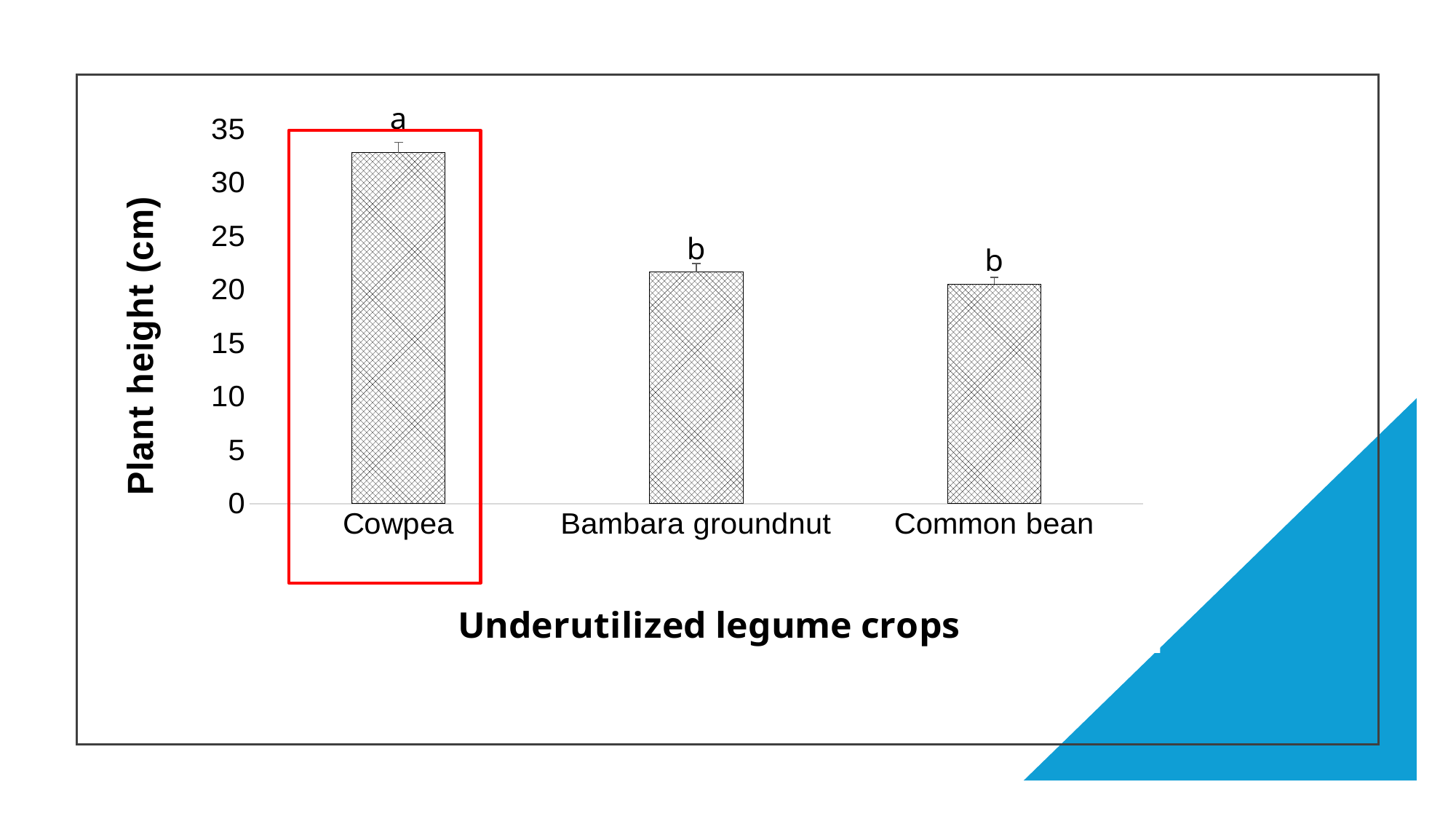
Which legume crop has the greatest plant height? Cowpea Is the plant height for Common bean greater or less than 25? less Which bar is outlined with a red box? Cowpea Which has a greater plant height, Cowpea or Common bean? Cowpea How many legume crops are plotted on the chart? 3 Is the plant height for Bambara groundnut greater or less than 20? greater What kind of chart is shown on the slide? bar chart Is the plant height for Cowpea greater or less than 35? less Which has a greater plant height, Bambara groundnut or Cowpea? Cowpea What is the title of the vertical axis? Plant height (cm)